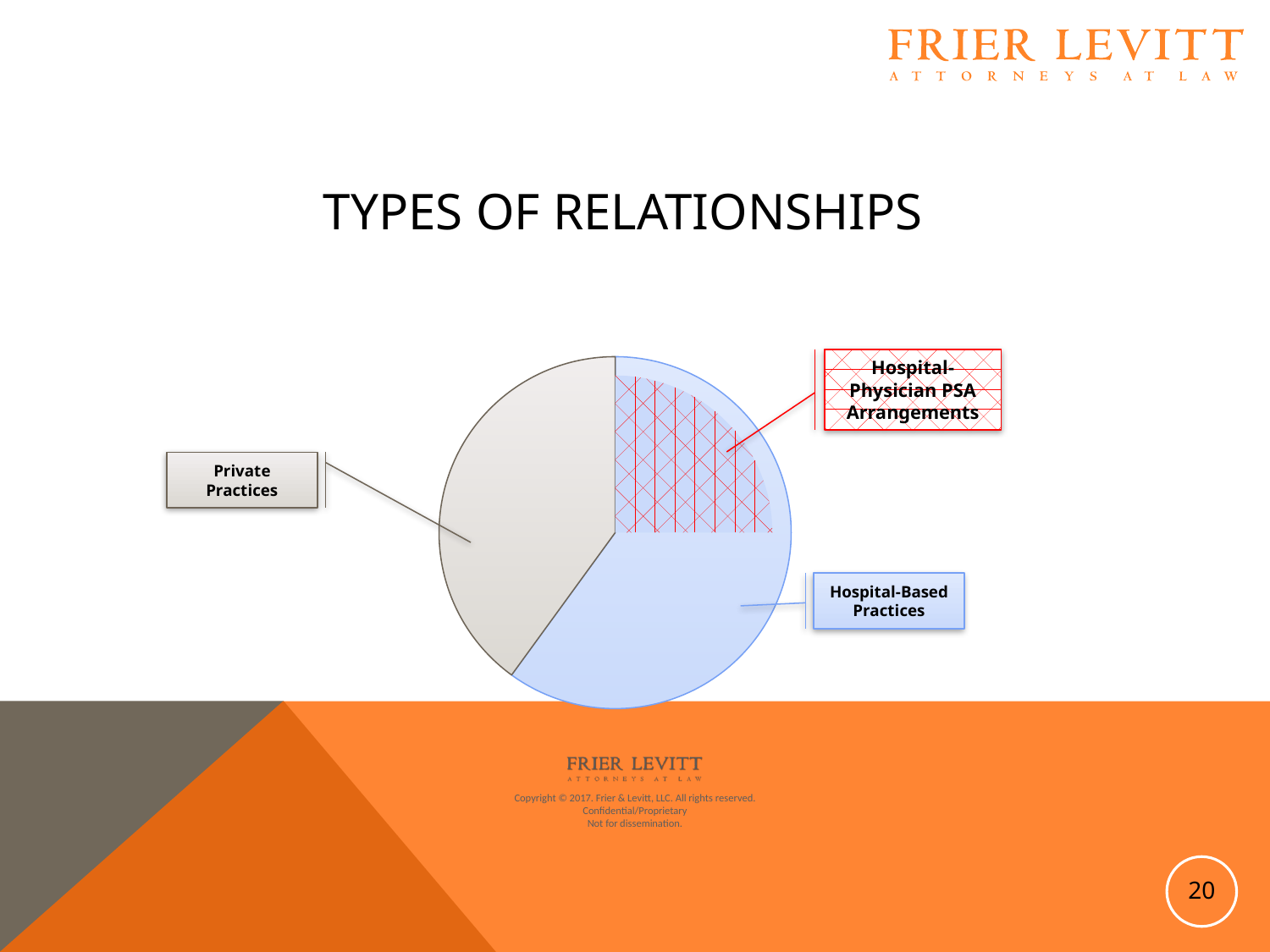
Which slice of the pie chart is the largest? Hospital-Based Practices Is the Hospital-Based Practices slice more or less than half of the pie? more Is the Private Practices slice more or less than half of the pie? less Which slice of the pie chart contains the hatched region labelled Hospital-Physician PSA Arrangements? Hospital-Based Practices What kind of chart is shown on the slide? pie chart Which slice is larger, Private Practices or Hospital-Based Practices? Hospital-Based Practices What is the title of the slide containing the pie chart? TYPES OF RELATIONSHIPS Which slice of the pie chart is the smallest? Private Practices